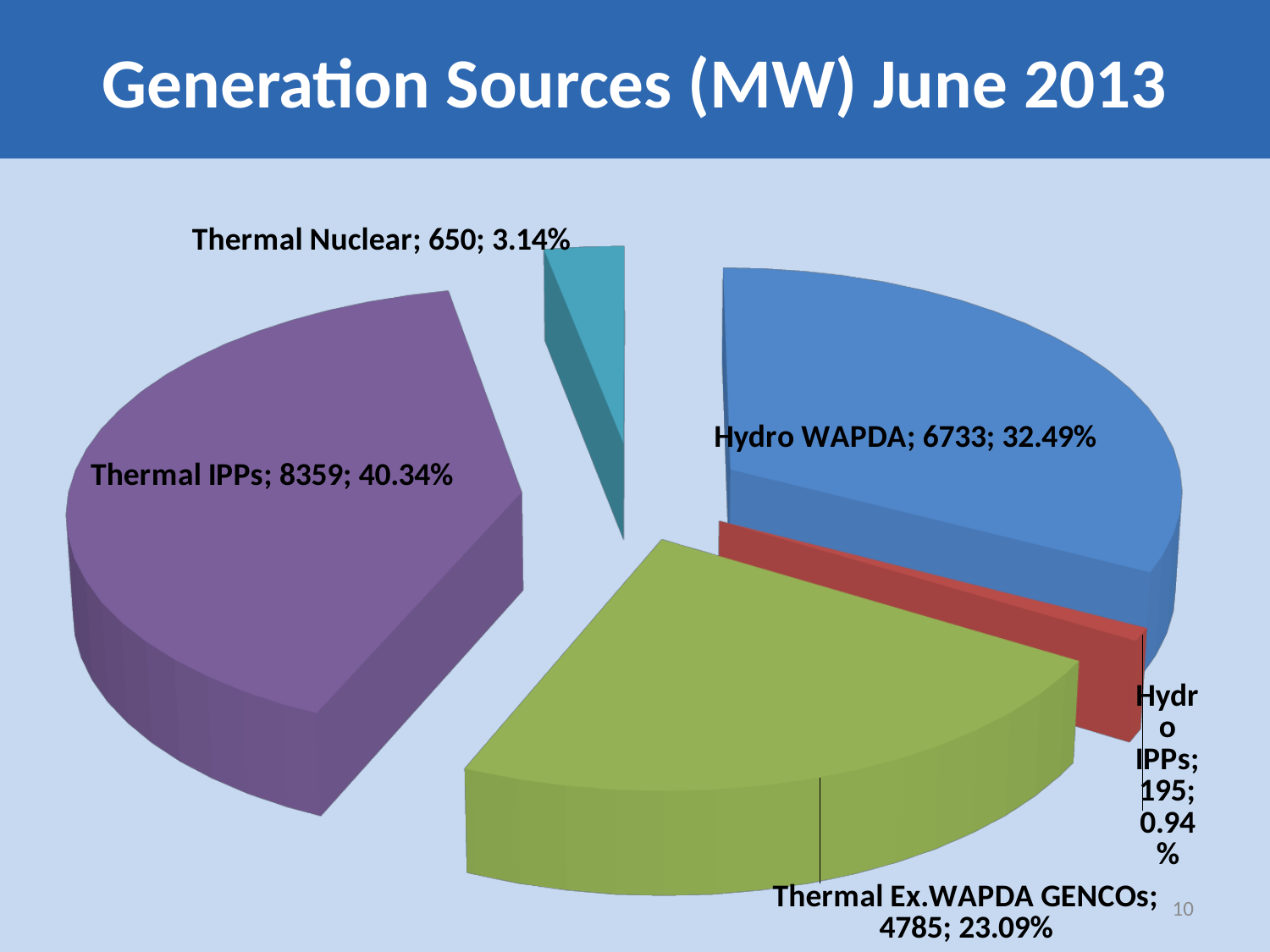
How many generation sources are shown in the pie chart? 5 What is the value for Hydro WAPDA? 6733 What is the value for Thermal IPPs? 8359 Which generation source has the smallest value? Hydro IPPs Which is larger, the value for Thermal Ex.WAPDA GENCOs or Thermal Nuclear? Thermal Ex.WAPDA GENCOs What share of the pie does Thermal Ex.WAPDA GENCOs represent? 23.09% What type of chart is shown on the slide? Pie chart What is the value for Hydro IPPs? 195 What is the value for Thermal Nuclear? 650 What share of the pie does Hydro WAPDA represent? 32.49% Which generation source has the largest value? Thermal IPPs What is the difference between the values for Thermal IPPs and Hydro WAPDA? 1626